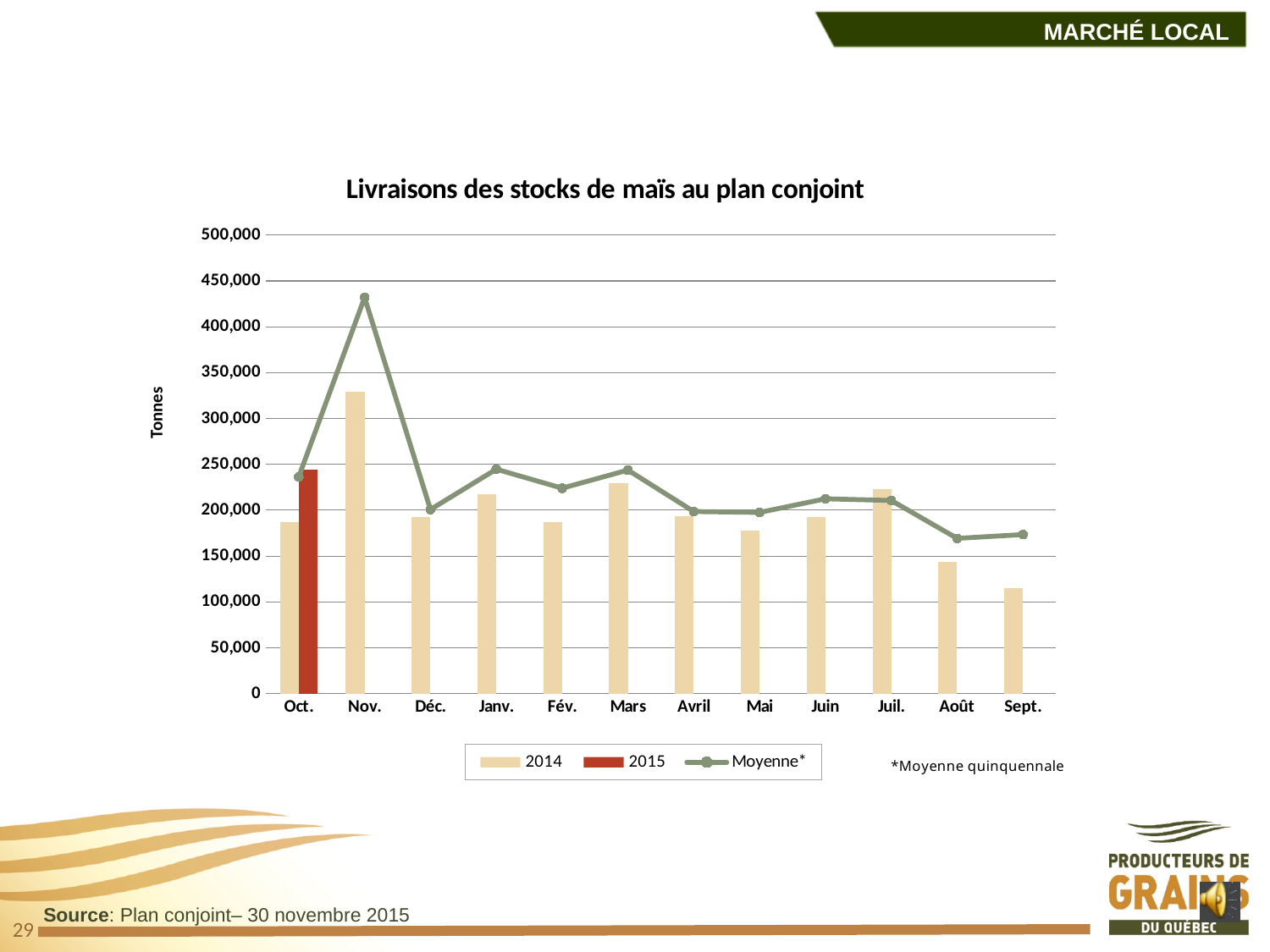
Is the 2014 value for Sept. greater or less than 150,000? less Is the 2014 value for Nov. greater or less than 300,000? greater Do the 2014 bars rise or fall from Juil. to Sept.? fall Is the Moyenne* value for Nov. greater or less than 400,000? greater For Oct., which is larger: the 2014 bar or the 2015 bar? 2015 What kind of chart is shown on the slide? A combined bar and line chart In which month is the 2014 bar the lowest? Sept. In which month does the Moyenne* line reach its highest point? Nov. In which month is the 2014 bar the highest? Nov. How many series does the legend list? 3 How many months are shown on the x axis? 12